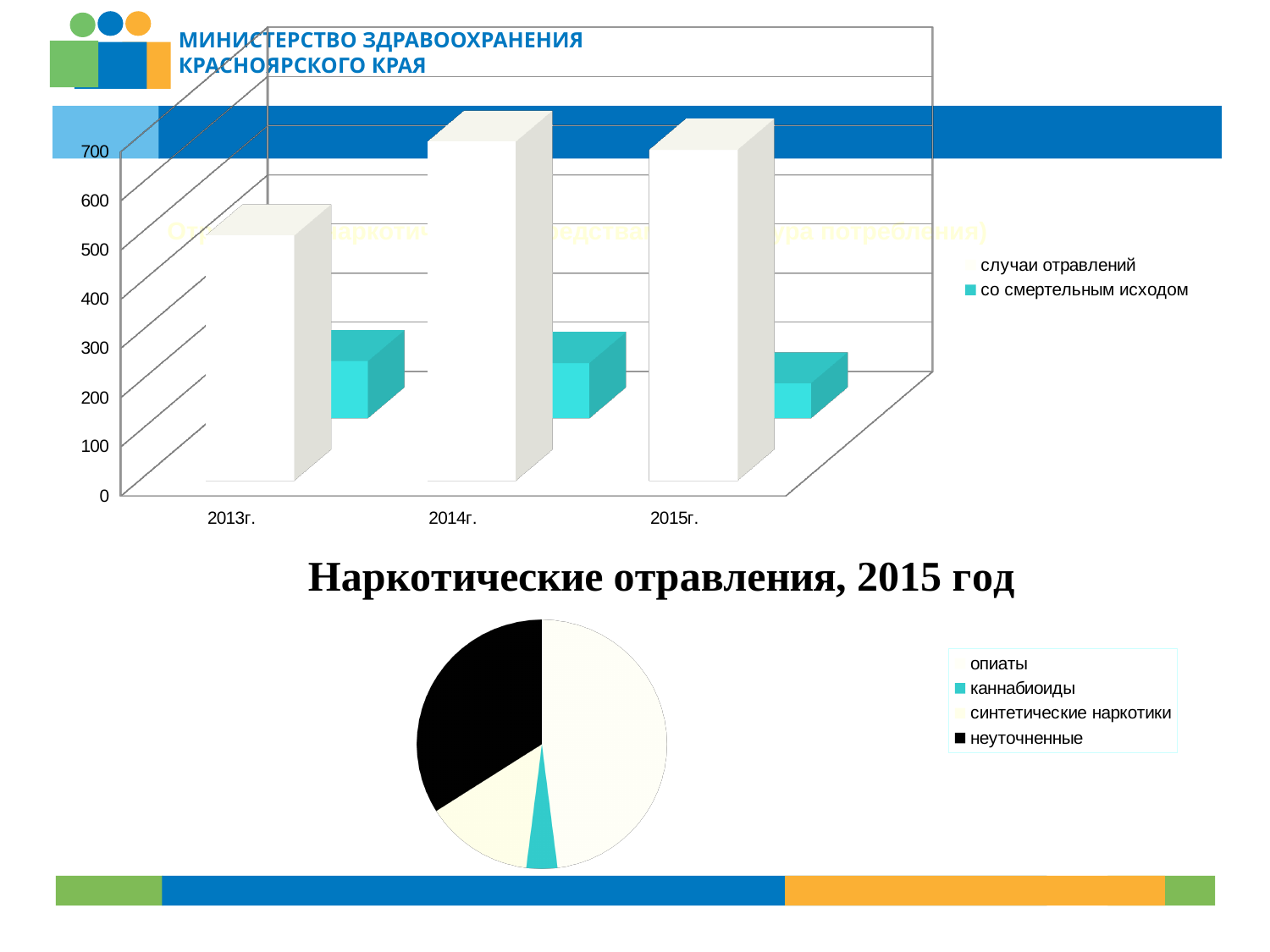
In the top bar chart, which year has the lowest value for "случаи отравлений"? 2013г. In the top bar chart, is the value for "случаи отравлений" in 2013г. greater or less than 400? greater In the pie chart "Наркотические отравления, 2015 год", which category has the smallest slice? каннабиоиды What kind of chart is the top chart on the slide? bar chart In the top bar chart, which year has the lowest value for "со смертельным исходом"? 2015г. What kind of chart is the chart titled "Наркотические отравления, 2015 год"? pie chart In the top bar chart, is the value for "со смертельным исходом" in 2015г. greater or less than 300? less How many series does the legend of the top bar chart list? 2 In the top bar chart, which is larger in 2015г.: "случаи отравлений" or "со смертельным исходом"? случаи отравлений In the top bar chart, is the value for "случаи отравлений" in 2014г. greater or less than 600? greater In the pie chart "Наркотические отравления, 2015 год", which category has the largest slice? опиаты How many years are shown on the x axis of the top bar chart? 3